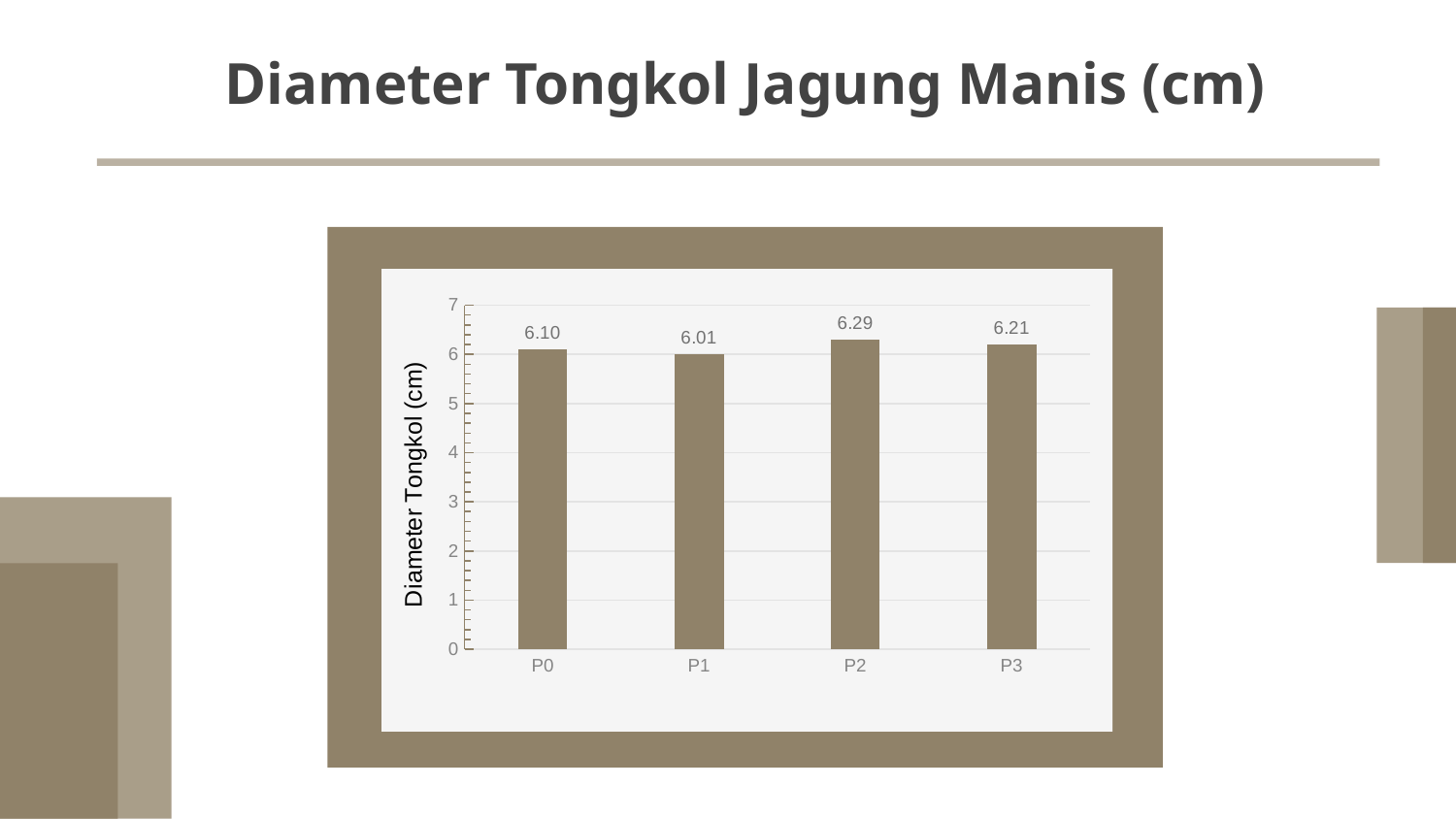
Which category has the lowest value? P1 What is the value for P3? 6.21 What is the label of the vertical axis? Diameter Tongkol (cm) What is the value for P0? 6.10 Is the value for P1 greater or less than 5? greater What kind of chart is shown on the slide? bar chart What is the difference between the values for P2 and P1? 0.28 Which category has the highest value? P2 What is the value for P2? 6.29 What is the value for P1? 6.01 Which is larger, the value for P3 or the value for P0? P3 How many categories are shown on the x axis? 4